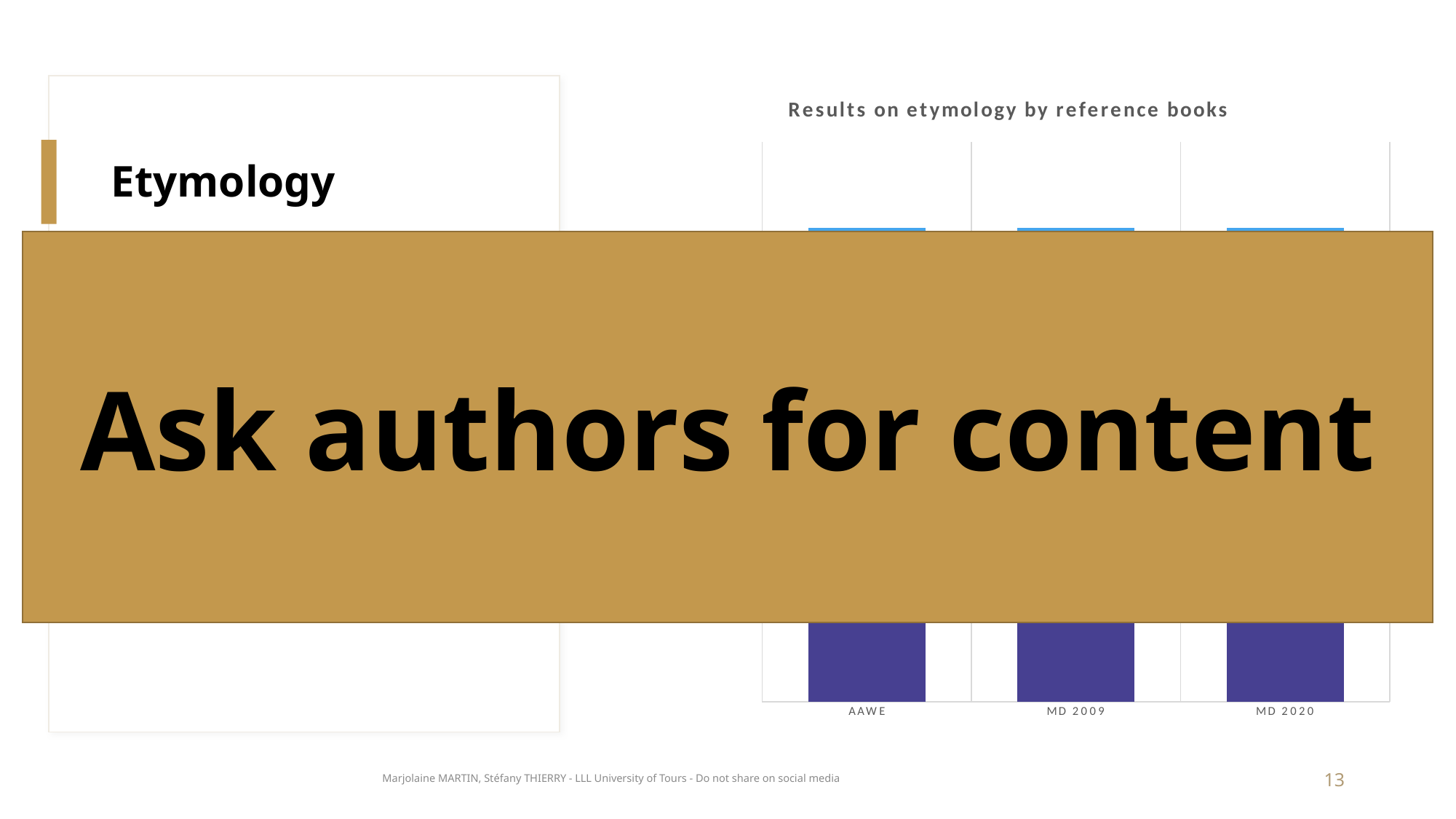
What is the title of the chart on the slide? Results on etymology by reference books Which category label appears first (leftmost) on the x axis of the chart? AAWE Which category label appears last (rightmost) on the x axis of the chart? MD 2020 How many categories are shown on the x axis of the chart? 3 What are the category labels on the x axis of the chart? AAWE, MD 2009, MD 2020 What kind of chart is shown on the slide? bar chart